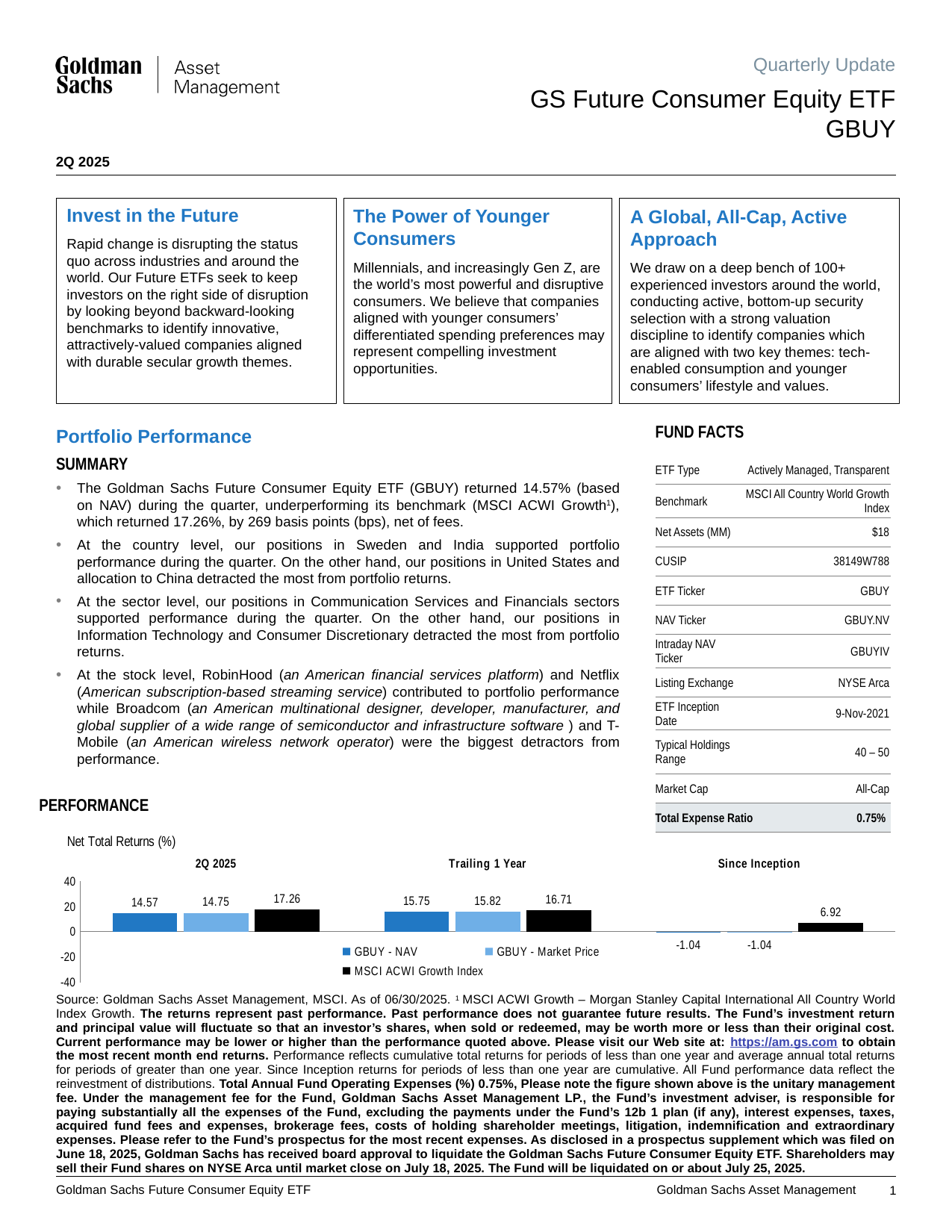
What is the MSCI ACWI Growth Index return for the Trailing 1 Year period? 16.71 Is the GBUY - NAV return for the Trailing 1 Year period larger or smaller than the MSCI ACWI Growth Index return for the same period? smaller How many series does the legend of the Net Total Returns chart list? 3 What is the difference between the MSCI ACWI Growth Index and GBUY - NAV returns for the Since Inception period? 7.96 What is the GBUY - Market Price return for the Since Inception period? -1.04 What colour are the MSCI ACWI Growth Index bars in the Net Total Returns chart? black What is the difference between the MSCI ACWI Growth Index and GBUY - NAV returns for 2Q 2025? 2.69 What kind of chart is used to show Net Total Returns (%)? bar chart Which series has the highest value in the 2Q 2025 group? MSCI ACWI Growth Index What is the GBUY - NAV return for 2Q 2025 in the Net Total Returns chart? 14.57 How many period groups are shown on the x axis of the Net Total Returns chart? 3 Which period shows the lowest GBUY - NAV return? Since Inception